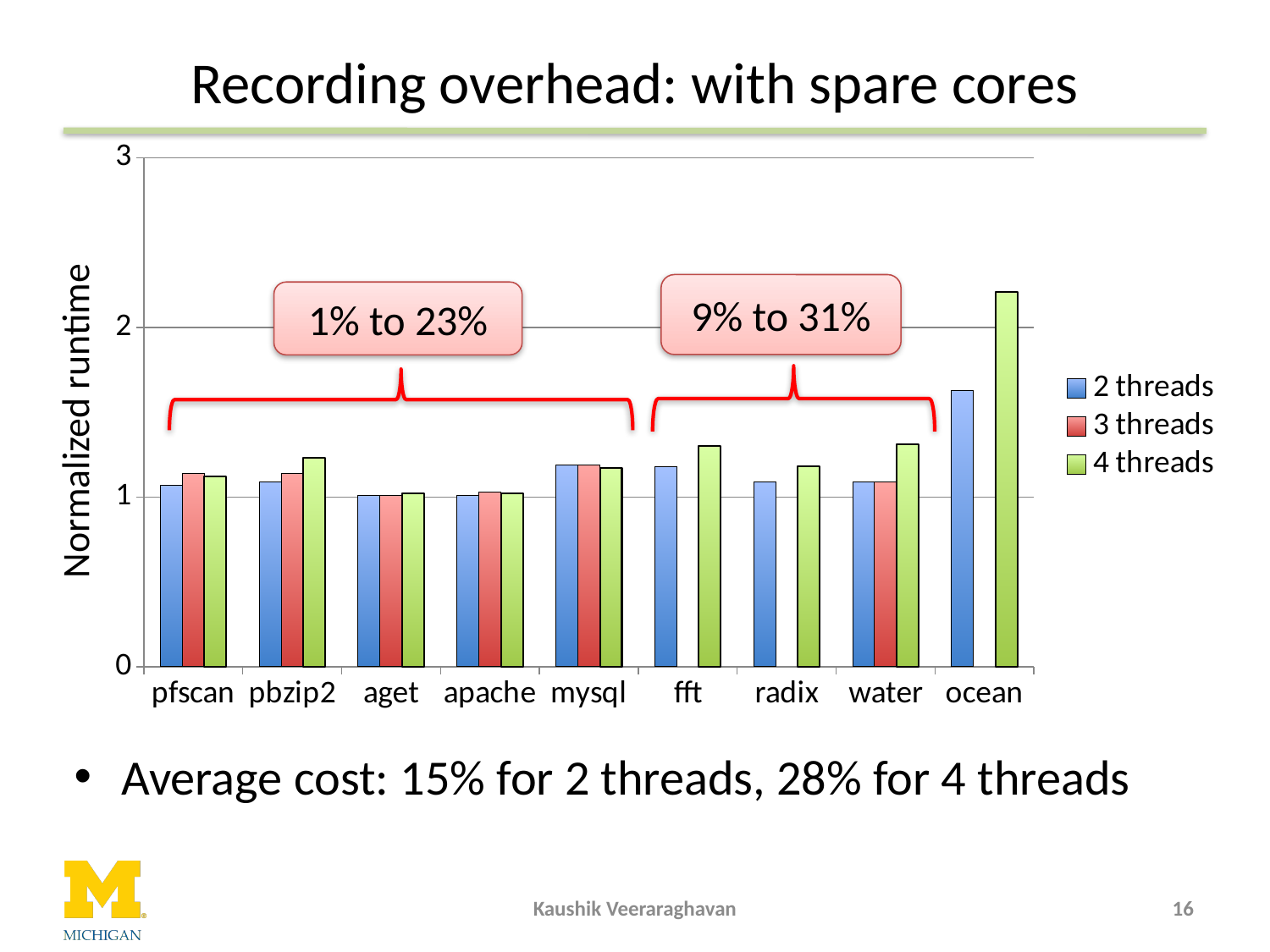
For ocean, which series has the larger value: 2 threads or 4 threads? 4 threads Is the 4 threads value for water greater or less than 1? greater For fft, which series has the larger value: 2 threads or 4 threads? 4 threads How many series does the chart's legend list? 3 What are the three entries listed in the chart's legend? 2 threads, 3 threads, 4 threads What is the label of the chart's y axis? Normalized runtime Which category has the tallest bar for the 2 threads series? ocean How many categories (benchmarks) are shown on the x axis of the chart? 9 What kind of chart is shown on the slide? bar chart Is the 2 threads value for ocean greater or less than 2? less Is the 4 threads value for ocean greater or less than 2? greater Which category has the tallest bar for the 4 threads series? ocean